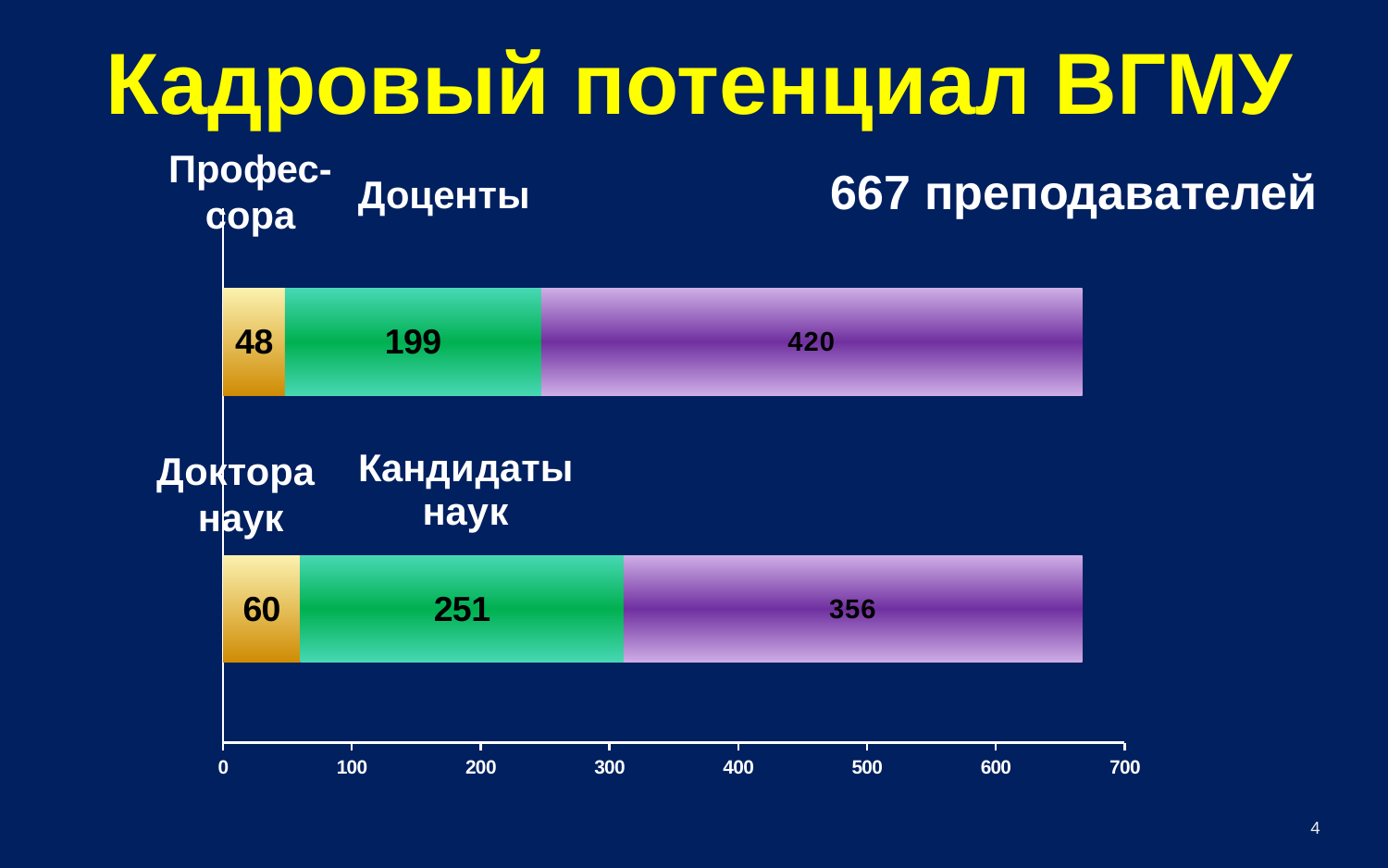
What type of chart is shown on the slide? stacked bar chart What is the value of the purple segment in the bottom bar? 356 What is the title of the slide? Кадровый потенциал ВГМУ What is the value for Доктора наук in the bottom bar? 60 What is the value for Доценты in the top bar? 199 What is the value for Профессора in the top bar? 48 What is the value for Кандидаты наук in the bottom bar? 251 What is the total of the top stacked bar (48 + 199 + 420)? 667 How many stacked bars does the chart contain? 2 Which is larger, the value for Доктора наук or the value for Профессора? Доктора наук What is the value of the purple segment in the top bar? 420 What is the difference between Кандидаты наук (251) and Доценты (199)? 52